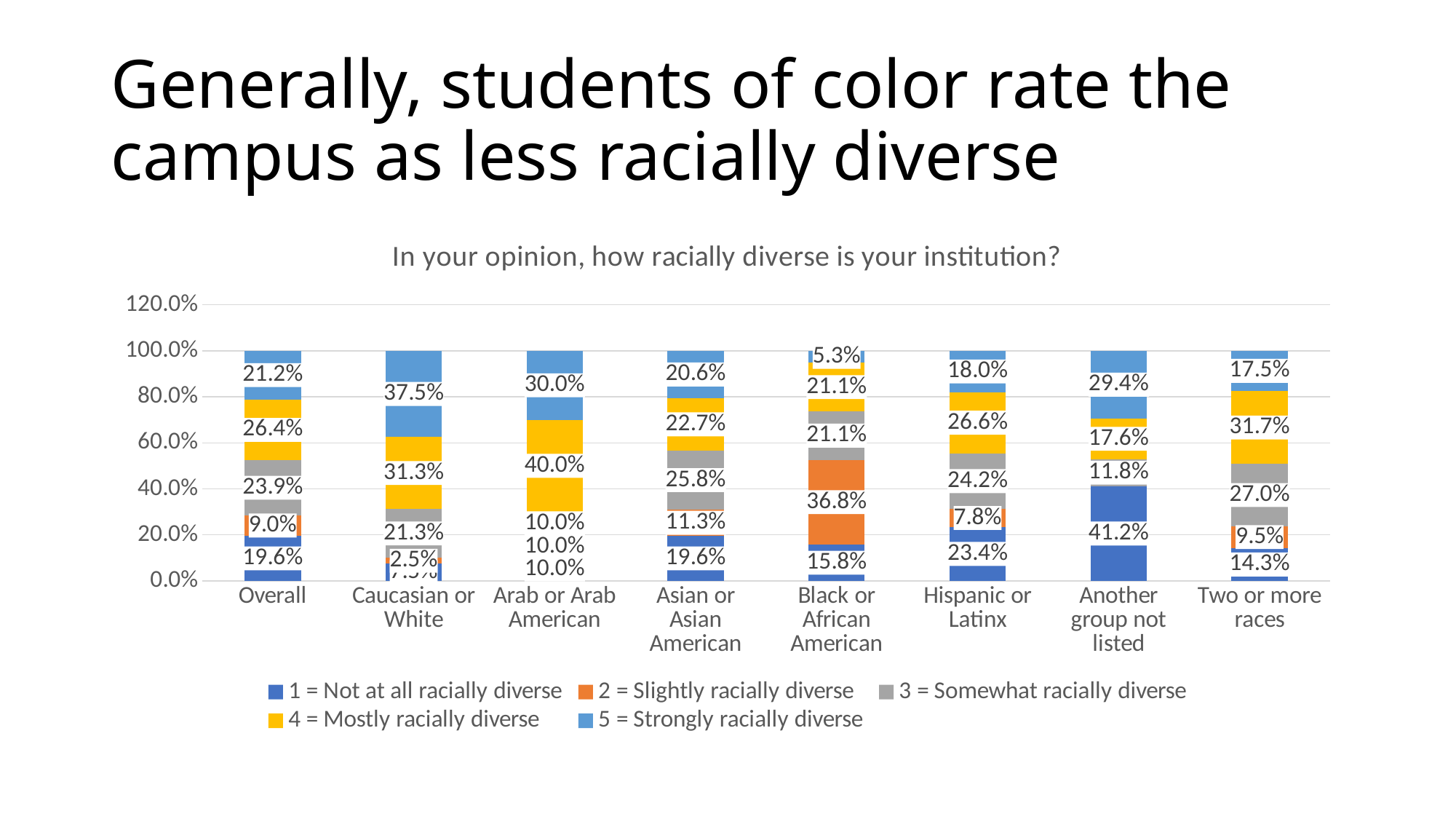
What percentage of respondents in the 'Another group not listed' category rated the institution as 1 = Not at all racially diverse? 41.2% How many series does the chart's legend list? 5 What is the difference in percentage points between the Caucasian or White and Black or African American shares rating the institution as 5 = Strongly racially diverse? 32.2 percentage points Which category has the lowest share of respondents rating the institution as 5 = Strongly racially diverse? Black or African American How many racial/ethnic categories are shown along the x axis of the chart? 8 What percentage of Arab or Arab American respondents rated the institution as 4 = Mostly racially diverse? 40.0% Which category has the highest share of respondents rating the institution as 5 = Strongly racially diverse? Caucasian or White What percentage of Black or African American respondents rated the institution as 2 = Slightly racially diverse? 36.8% Which is larger: the share of Hispanic or Latinx respondents or the share of Overall respondents rating the institution as 1 = Not at all racially diverse? Hispanic or Latinx What is the title of the chart? In your opinion, how racially diverse is your institution? What percentage of Overall respondents rated the institution as 5 = Strongly racially diverse? 21.2% What kind of chart is shown on the slide? Stacked bar chart